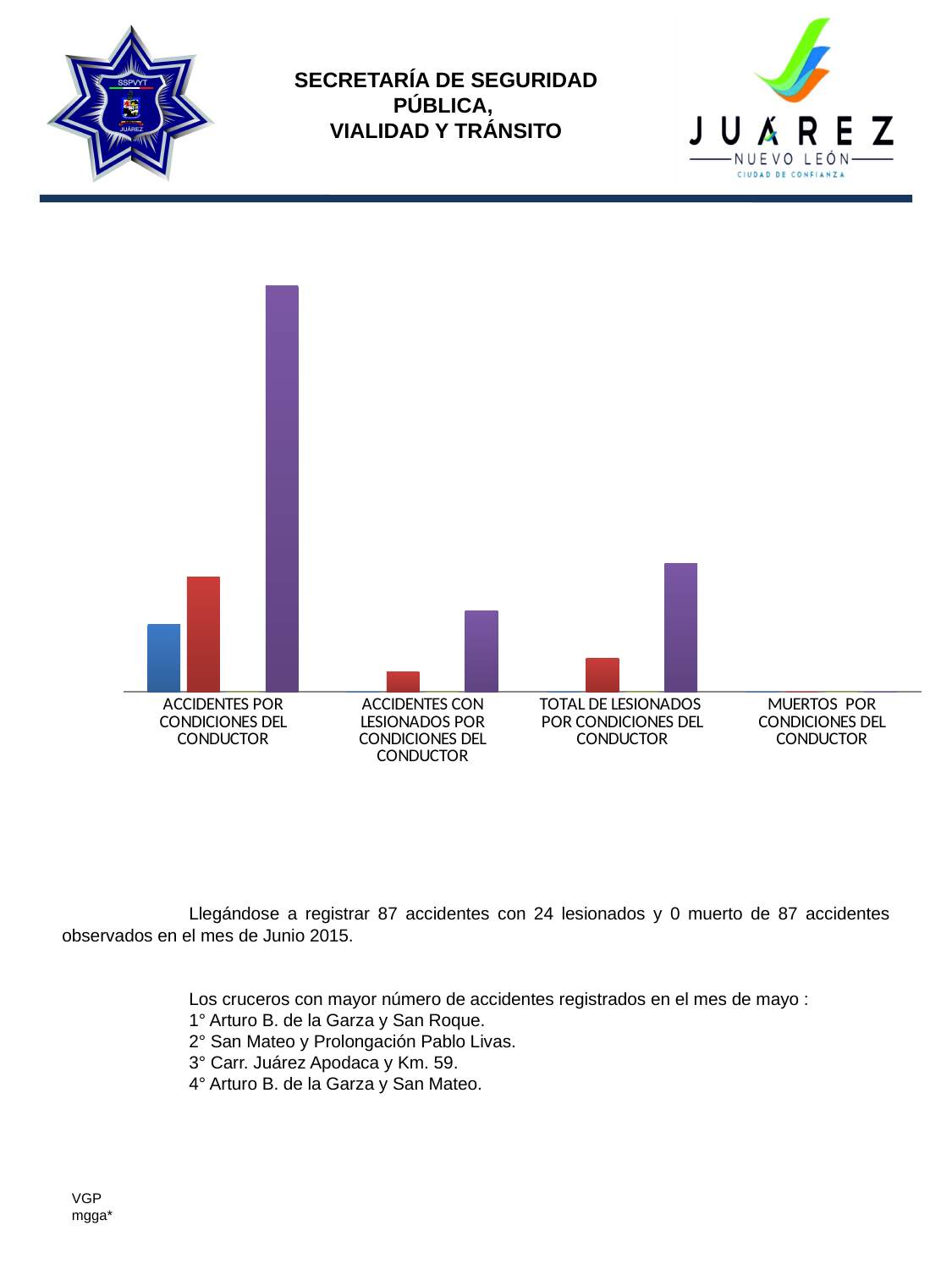
How many different bar colours are used in the chart? 3 Which category has the shortest visible bar in the chart? ACCIDENTES CON LESIONADOS POR CONDICIONES DEL CONDUCTOR In the ACCIDENTES POR CONDICIONES DEL CONDUCTOR category, which bar is taller, the purple one or the red one? the purple one In the ACCIDENTES POR CONDICIONES DEL CONDUCTOR category, which bar is taller, the red one or the blue one? the red one Which category has the tallest bar in the chart? ACCIDENTES POR CONDICIONES DEL CONDUCTOR Which category shows no visible bars at all? MUERTOS POR CONDICIONES DEL CONDUCTOR Which category is the only one with a blue bar? ACCIDENTES POR CONDICIONES DEL CONDUCTOR What kind of chart is shown on the slide? bar chart Is the purple bar taller for TOTAL DE LESIONADOS POR CONDICIONES DEL CONDUCTOR or for ACCIDENTES CON LESIONADOS POR CONDICIONES DEL CONDUCTOR? TOTAL DE LESIONADOS POR CONDICIONES DEL CONDUCTOR How many categories are shown along the x axis of the chart? 4